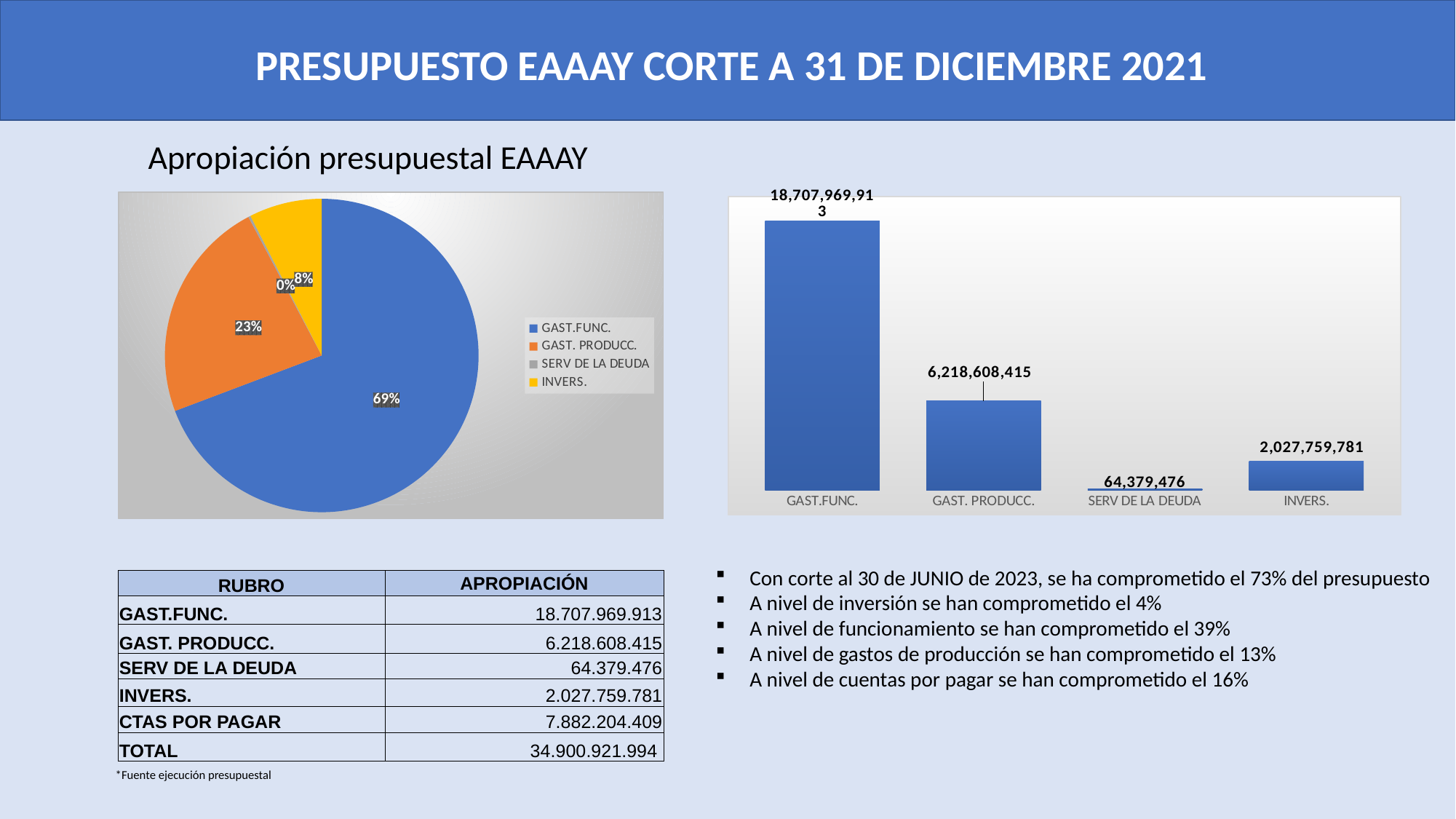
What kind of chart is the chart on the right of the slide? bar chart In the pie chart on the left, which category has the largest slice? GAST.FUNC. In the bar chart on the right, which is larger, GAST. PRODUCC. or INVERS.? GAST. PRODUCC. What kind of chart is the chart on the left of the slide? pie chart How many entries does the legend of the pie chart on the left list? 4 In the pie chart on the left, what share does INVERS. have? 8% In the bar chart on the right, what is the value for SERV DE LA DEUDA? 64,379,476 In the bar chart on the right, which category has the lowest value? SERV DE LA DEUDA In the bar chart on the right, what is the value for GAST. PRODUCC.? 6,218,608,415 In the pie chart on the left, what share does GAST.FUNC. have? 69% In the pie chart on the left, what share does GAST. PRODUCC. have? 23% In the bar chart on the right, what is the value for INVERS.? 2,027,759,781